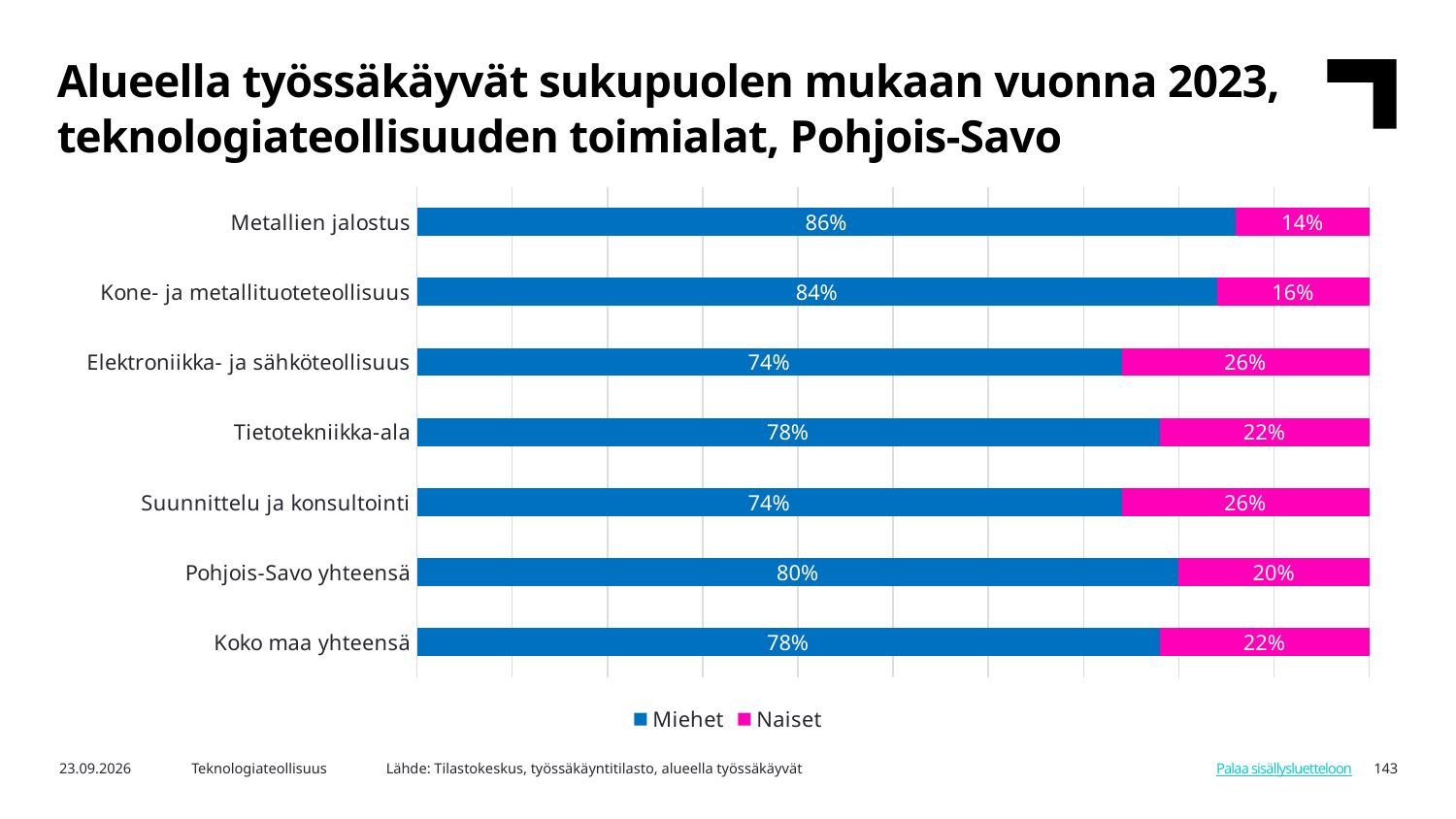
What is the Miehet share for Metallien jalostus? 86% How many series does the legend list? 2 How many categories are shown on the chart? 7 What is the Naiset share for Pohjois-Savo yhteensä? 20% Which category has the highest Miehet share? Metallien jalostus What is the difference between the Naiset share for Kone- ja metallituoteteollisuus and for Metallien jalostus? 2 percentage points What is the Miehet share for Koko maa yhteensä? 78% Which is larger: the Naiset share for Tietotekniikka-ala or for Suunnittelu ja konsultointi? Suunnittelu ja konsultointi Which category has the lowest Naiset share? Metallien jalostus What is the Naiset share for Elektroniikka- ja sähköteollisuus? 26% What kind of chart is shown on the slide? Stacked bar chart What is the total of the stacked bar for Tietotekniikka-ala? 100%